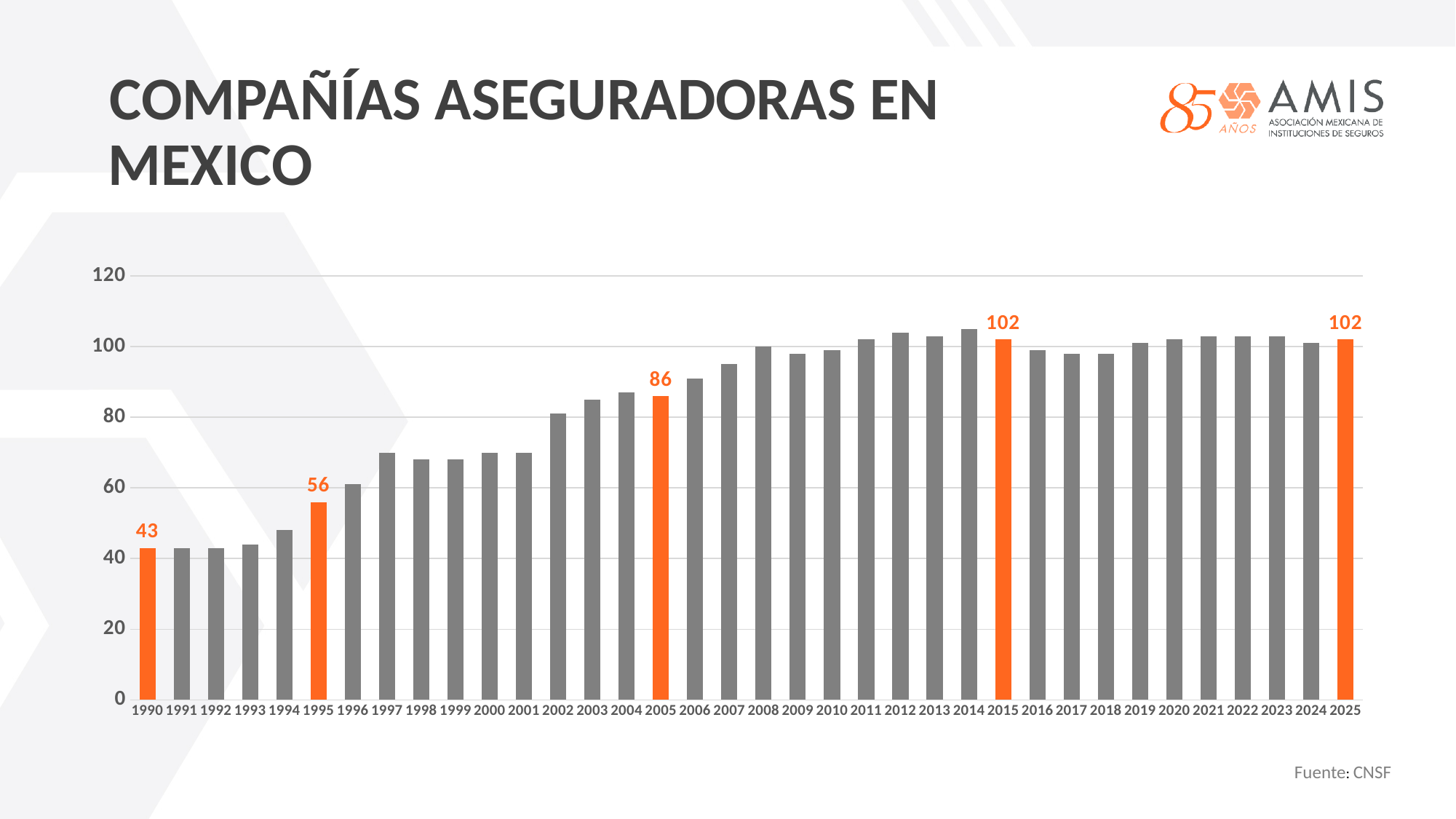
What kind of chart is shown on the slide? bar chart What is the difference between the values for 2025 and 1990? 59 Which is larger, the value for 2005 or the value for 1995? 2005 What is the value for 1990? 43 Is the value for 1997 greater or less than 60? greater Is the value for 2003 greater or less than 80? greater What is the difference between the values for 2005 and 1995? 30 What is the value for 2025? 102 What is the value for 2005? 86 Do the values generally rise or fall from 1990 to 2025? rise What is the value for 2015? 102 What is the value for 1995? 56